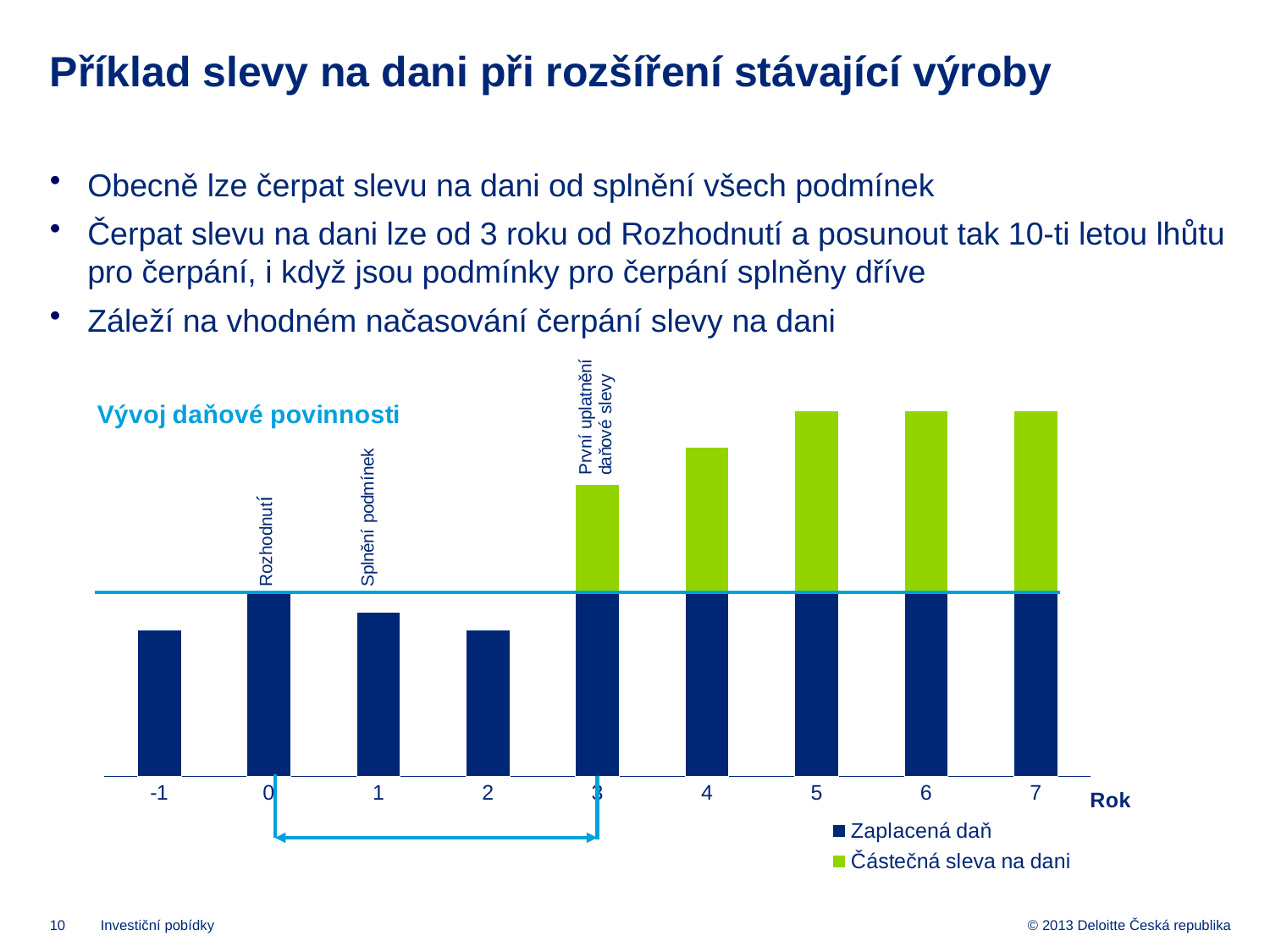
What kind of chart is shown on the slide? bar chart Do the 'Částečná sleva na dani' bars rise or fall from year 3 to year 5? rise How many years (categories) are shown on the x axis of the chart? 9 Which year has the smallest 'Částečná sleva na dani' bar? 3 How many years have a 'Částečná sleva na dani' bar? 5 What are the two series named in the chart legend? Zaplacená daň; Částečná sleva na dani Which year on the chart is annotated with 'Rozhodnutí'? 0 What is the title of the chart? Vývoj daňové povinnosti In which year does the 'Částečná sleva na dani' series first appear in the chart? 3 How many series does the chart legend list? 2 Is the 'Zaplacená daň' bar larger in year 0 or in year -1? year 0 Is the 'Částečná sleva na dani' bar larger in year 4 or in year 3? year 4